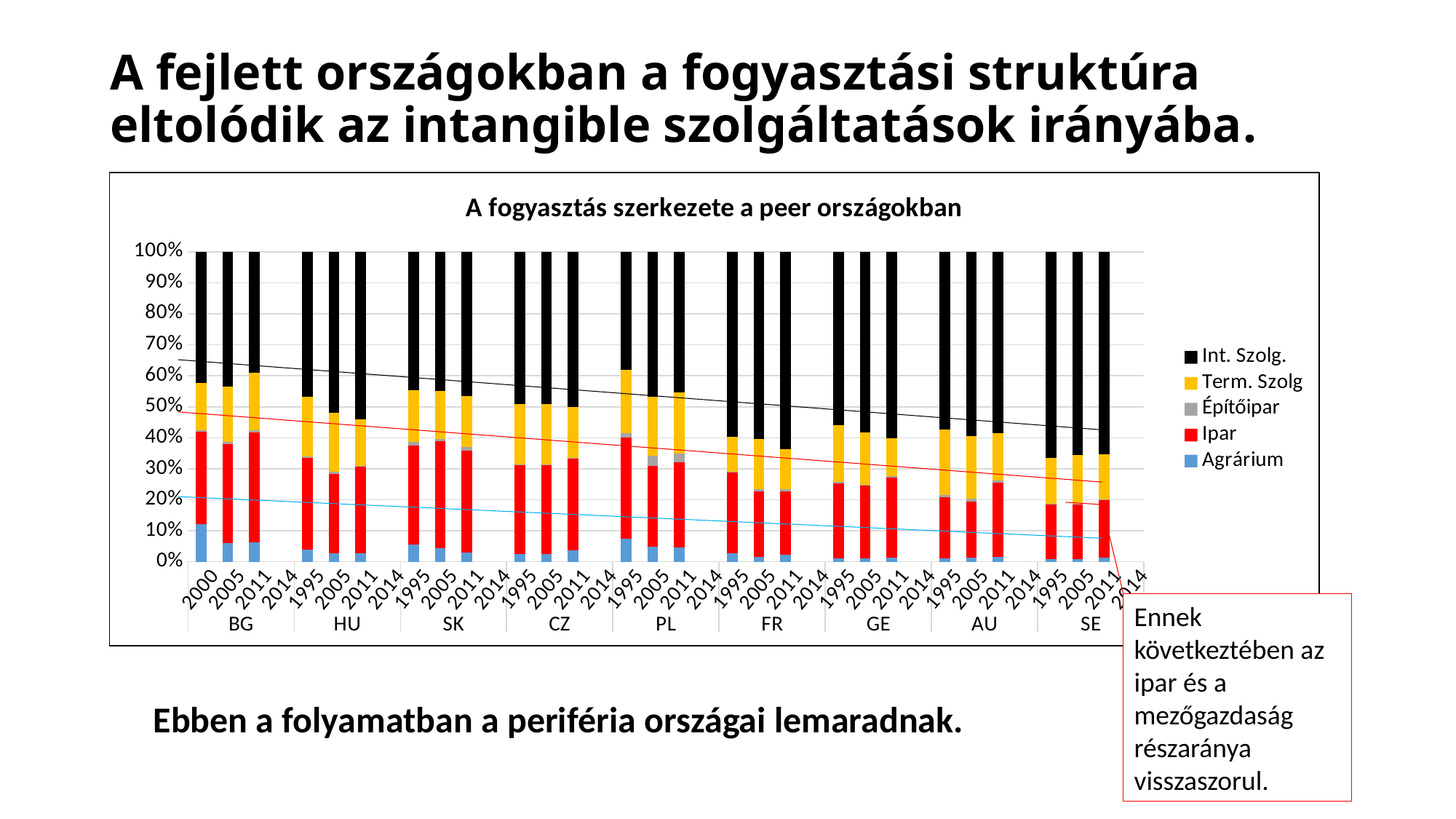
Is the Agrárium share for SE in 2011 greater or less than 10%? less Which colour represents the Ipar series in the chart? red What is the title of the chart? A fogyasztás szerkezete a peer országokban How many series does the chart legend list? 5 How many country groups are shown along the x axis of the chart? 9 Is the Int. Szolg. share for SE in 2011 greater or less than 60%? greater What kind of chart is shown on the slide? stacked bar chart Is the Agrárium share for BG in 2000 greater or less than 10%? greater How many year labels are shown under each country group on the x axis? 4 Which is larger: the Agrárium share for BG in 2000 or the Agrárium share for SE in 2011? BG in 2000 Does the Int. Szolg. share generally rise or fall moving from BG on the left to SE on the right? rise Which country group has the largest Agrárium share in any of its bars? BG